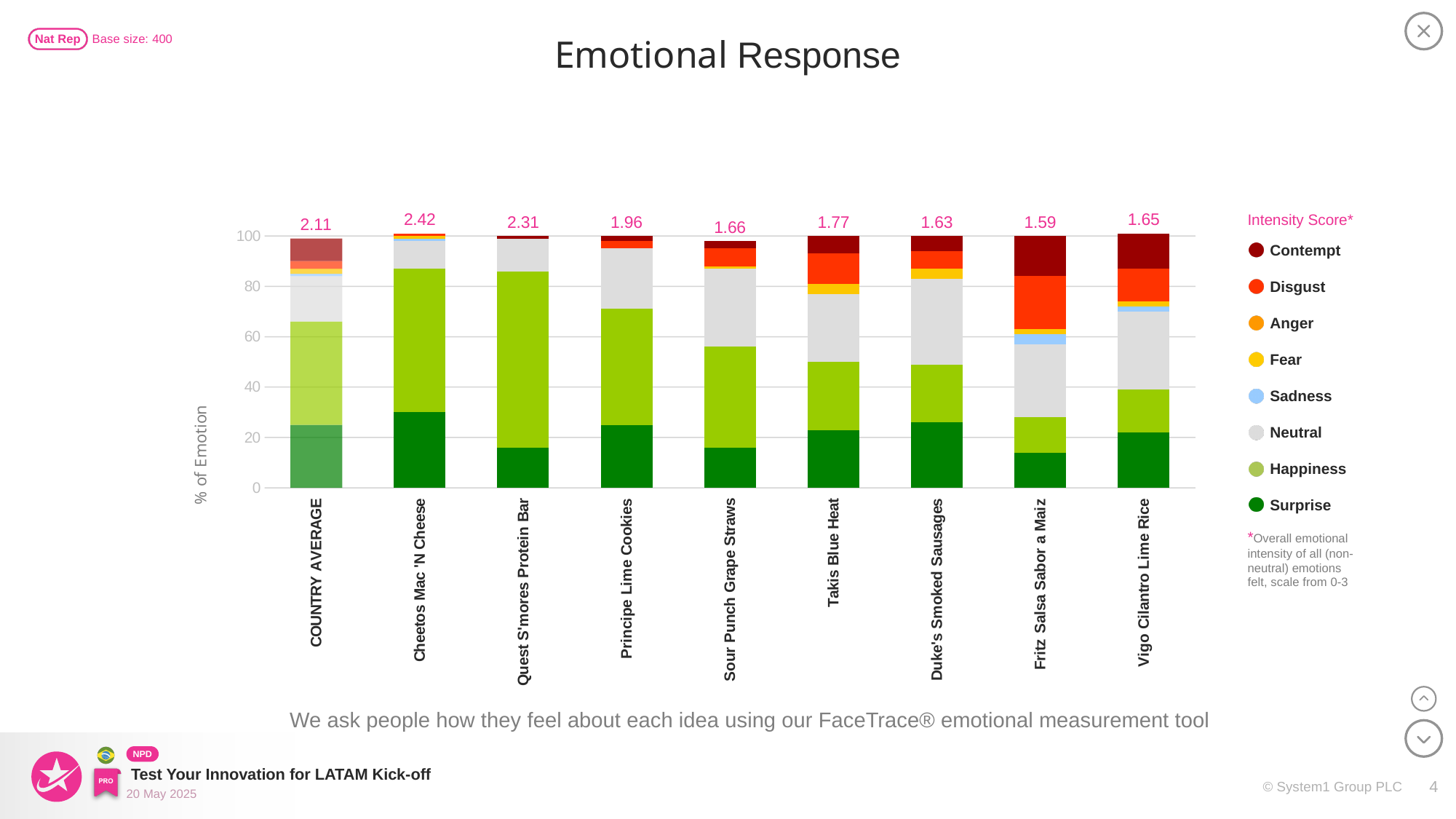
What is the label on the y axis of the chart? % of Emotion How many categories are shown along the x axis? 9 What is the Intensity Score shown above the bar for Takis Blue Heat? 1.77 What is the Intensity Score shown above the bar for Cheetos Mac 'N Cheese? 2.42 Which category has the highest Intensity Score? Cheetos Mac 'N Cheese How many emotions does the legend list? 8 What kind of chart is shown on the slide? Stacked bar chart Is the Surprise share for Cheetos Mac 'N Cheese greater or less than 20? greater Which category has the lowest Intensity Score? Fritz Salsa Sabor a Maiz What is the difference between the Intensity Scores of Cheetos Mac 'N Cheese and Fritz Salsa Sabor a Maiz? 0.83 What is the difference between the Intensity Scores of COUNTRY AVERAGE and Sour Punch Grape Straws? 0.45 Which has a higher Intensity Score, Quest S'mores Protein Bar or Principe Lime Cookies? Quest S'mores Protein Bar